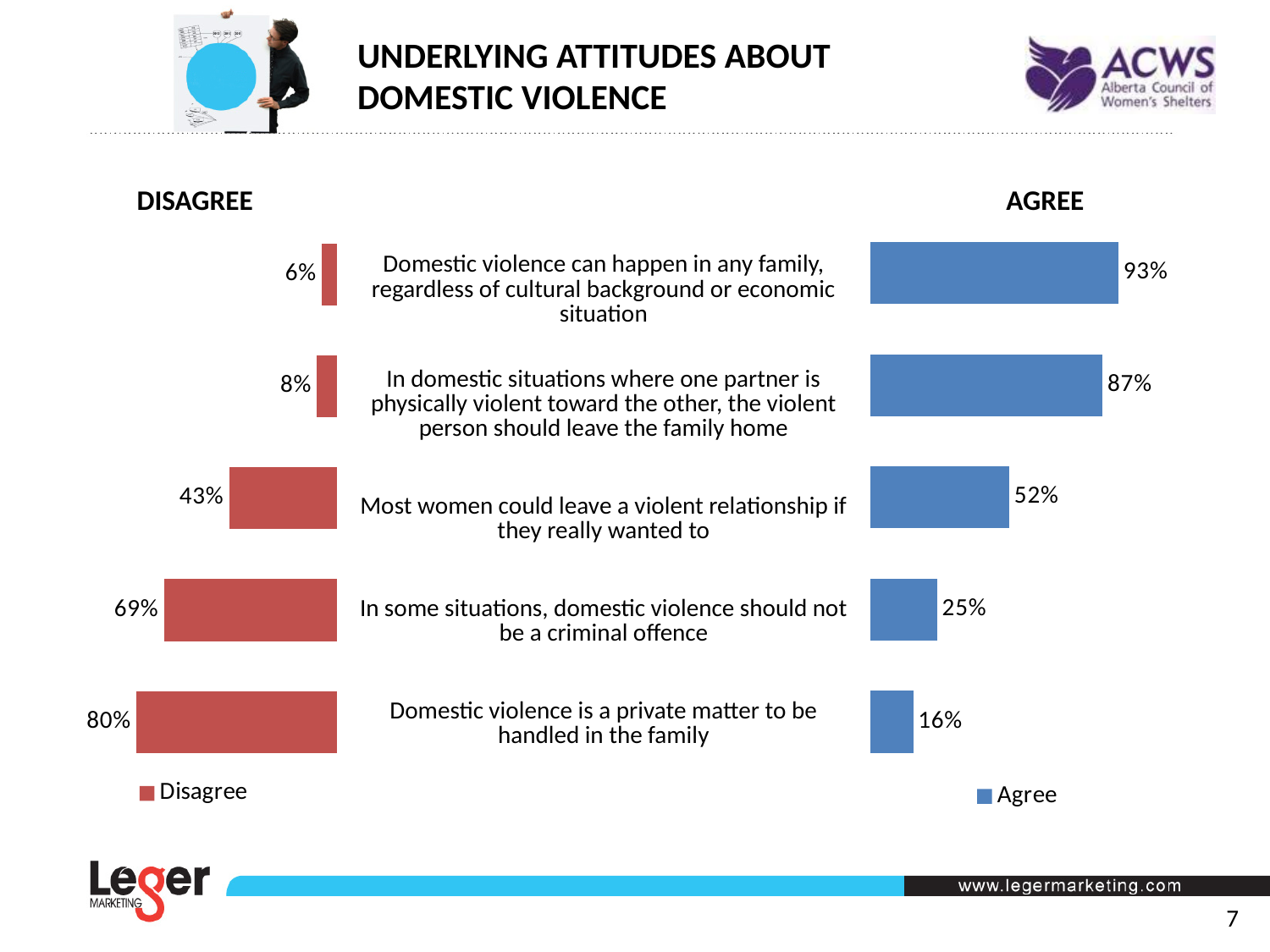
What is the difference between the Agree and Disagree percentages for the statement that the violent person should leave the family home? 79% In the Disagree chart on the left, what percentage disagree that in some situations, domestic violence should not be a criminal offence? 69% What type of chart is used on this slide? Bar chart In the Agree chart on the right, which statement has the highest agreement? Domestic violence can happen in any family, regardless of cultural background or economic situation In the Disagree chart on the left, which statement has the highest disagreement? Domestic violence is a private matter to be handled in the family In the Agree chart on the right, what percentage agree that most women could leave a violent relationship if they really wanted to? 52% How many statements are shown in the charts? 5 In the Agree chart on the right, which statement has the lowest agreement? Domestic violence is a private matter to be handled in the family In the Agree chart on the right, what percentage agree that domestic violence can happen in any family, regardless of cultural background or economic situation? 93% What colour are the bars in the Disagree chart on the left? Red In the Disagree chart on the left, what percentage disagree that domestic violence is a private matter to be handled in the family? 80% For the statement that most women could leave a violent relationship if they really wanted to, is the Agree percentage or the Disagree percentage larger? Agree